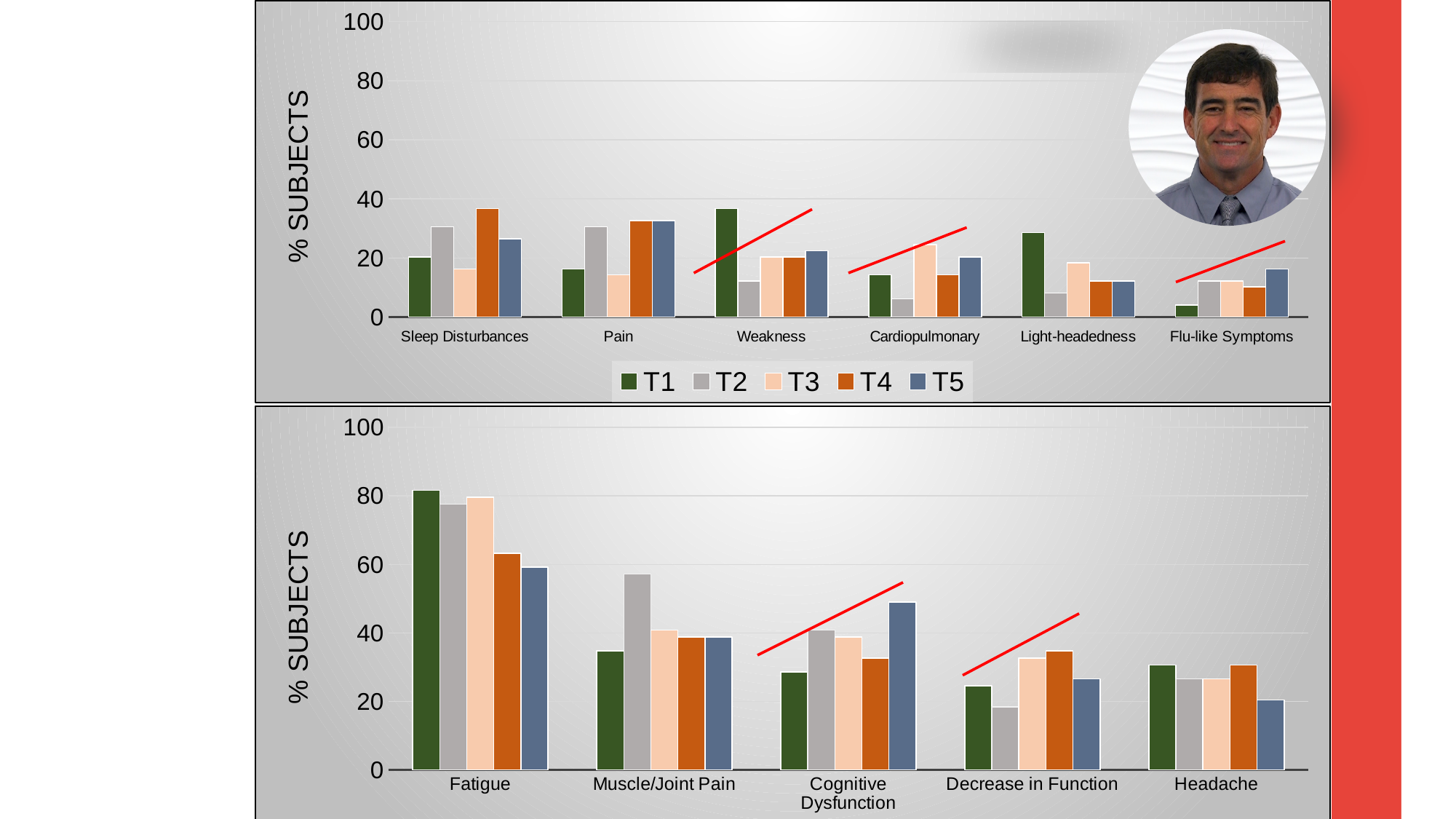
In the top chart, is the T1 value for Flu-like Symptoms greater or less than 20? less In the bottom chart, is the T2 value for Muscle/Joint Pain greater or less than 40? greater What type of chart is the top chart on the slide? bar chart How many series does the legend of the top chart list? 5 In the top chart, which category has the highest T1 value? Weakness In the top chart, is the T1 value for Weakness greater or less than 20? greater How many categories are shown on the x axis of the bottom chart? 5 What is the label on the y axis of the bottom chart? % SUBJECTS How many categories are shown on the x axis of the top chart? 6 In the top chart, which category has the lowest T1 value? Flu-like Symptoms In the top chart, for Sleep Disturbances, which is larger: the T1 value or the T4 value? T4